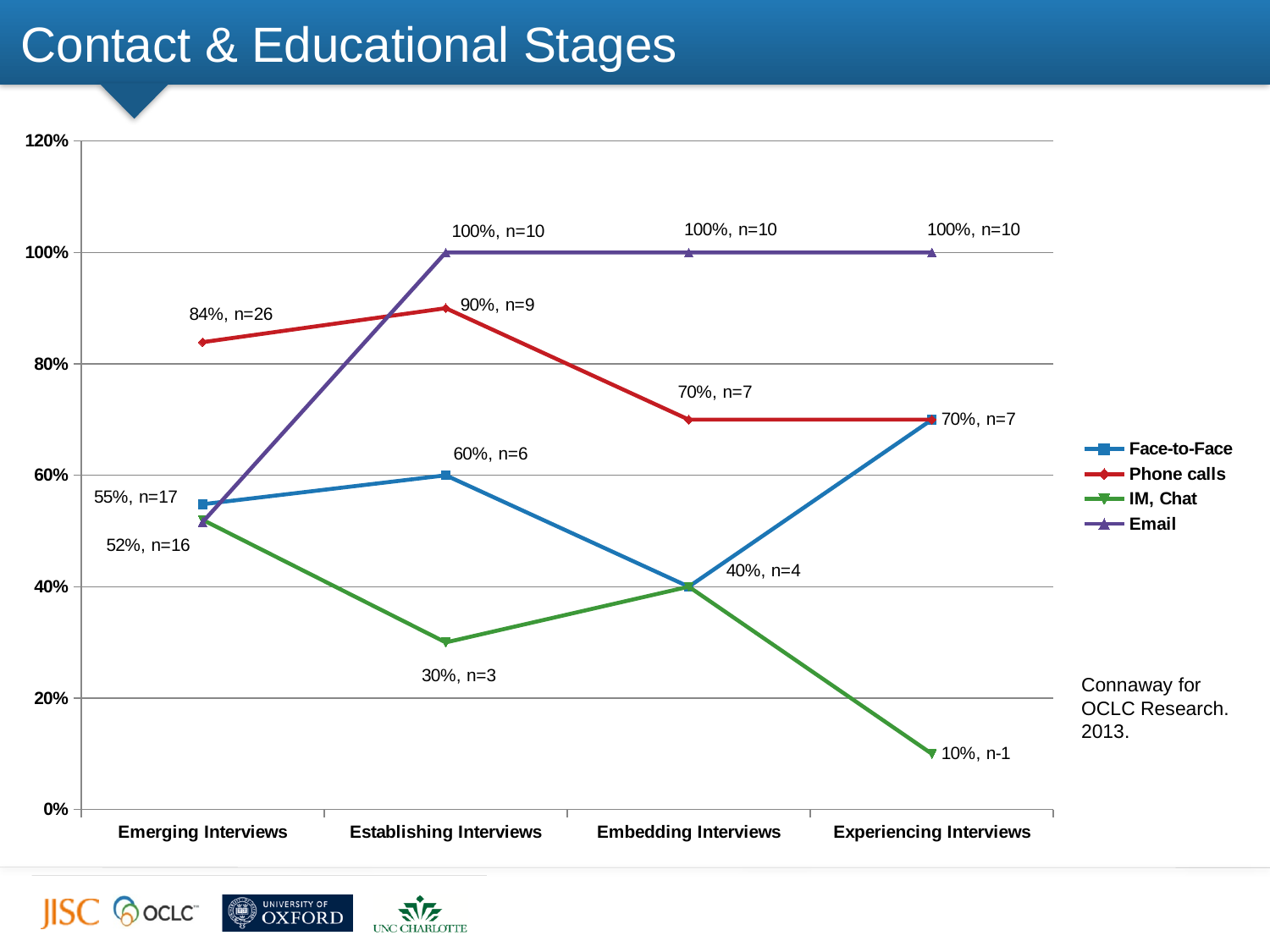
Does the IM, Chat line rise or fall from Embedding Interviews to Experiencing Interviews? Fall What is the difference between Phone calls and IM, Chat at Establishing Interviews? 60 percentage points What type of chart is shown on the slide? Line chart What is the value for Email at Embedding Interviews? 100% What is the value for IM, Chat at Experiencing Interviews? 10% Which series has the highest value at Establishing Interviews? Email What is the value for Phone calls at Emerging Interviews? 84% Which series has the lowest value at Experiencing Interviews? IM, Chat How many interview stages are shown on the x axis? 4 What is the value for IM, Chat at Establishing Interviews? 30% What is the value for Phone calls at Establishing Interviews? 90% How many series does the legend list? 4